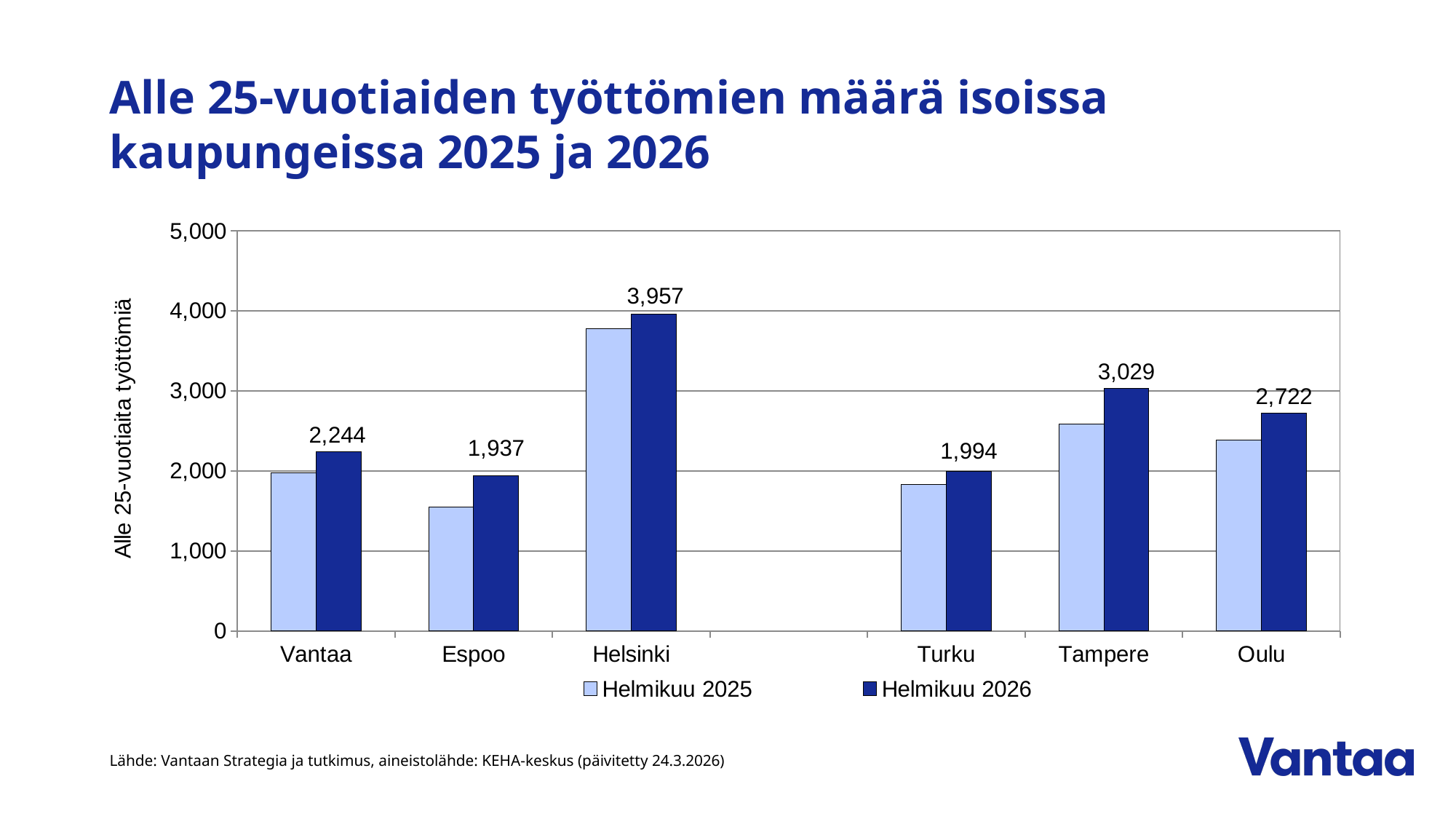
What is the difference between the Helmikuu 2026 values for Tampere and Oulu? 307 Which city has the highest value in the Helmikuu 2026 series? Helsinki Which is larger in the Helmikuu 2026 series, Vantaa or Turku? Vantaa What is the value for Oulu in the Helmikuu 2026 series? 2,722 What kind of chart is shown on the slide? Bar chart Is the Helmikuu 2025 value for Tampere greater or less than 2,000? greater How many series does the legend list? 2 What is the value for Vantaa in the Helmikuu 2026 series? 2,244 How many cities are shown on the x axis? 6 Which city has the lowest value in the Helmikuu 2026 series? Espoo What is the value for Helsinki in the Helmikuu 2026 series? 3,957 Is the Helmikuu 2025 value for Espoo greater or less than 2,000? less